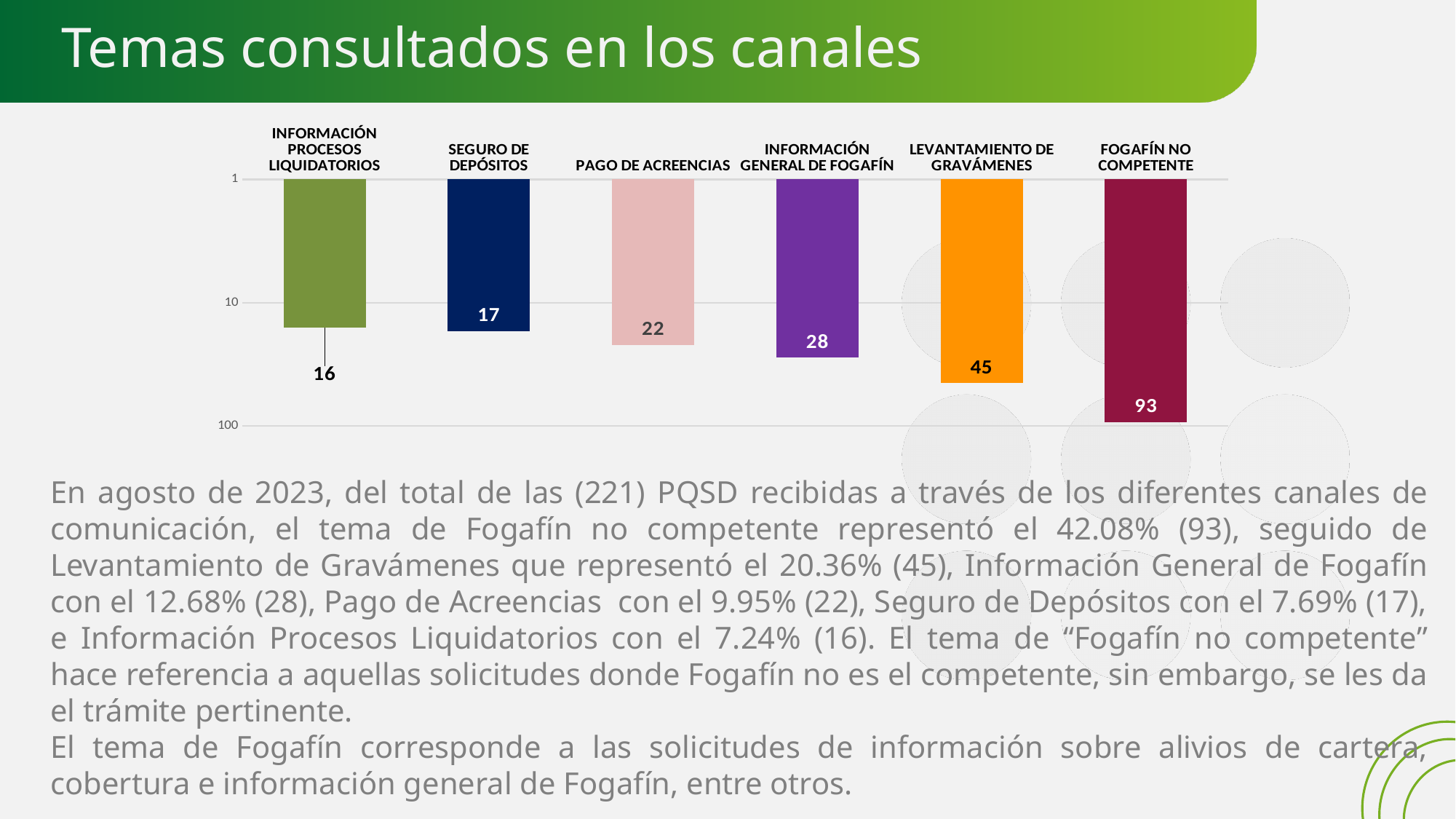
What is the value for LEVANTAMIENTO DE GRAVÁMENES? 45 What is the difference between the values for INFORMACIÓN GENERAL DE FOGAFÍN and PAGO DE ACREENCIAS? 6 What kind of chart is shown on the slide? Bar chart What is the difference between the values for FOGAFÍN NO COMPETENTE and LEVANTAMIENTO DE GRAVÁMENES? 48 What is the value for SEGURO DE DEPÓSITOS? 17 Do the values rise or fall from left to right across the categories? Rise Which is larger, the value for INFORMACIÓN GENERAL DE FOGAFÍN or the value for SEGURO DE DEPÓSITOS? INFORMACIÓN GENERAL DE FOGAFÍN How many categories are shown in the chart? 6 Which category has the lowest value? INFORMACIÓN PROCESOS LIQUIDATORIOS Which category has the highest value? FOGAFÍN NO COMPETENTE What is the value for FOGAFÍN NO COMPETENTE? 93 What is the value for PAGO DE ACREENCIAS? 22